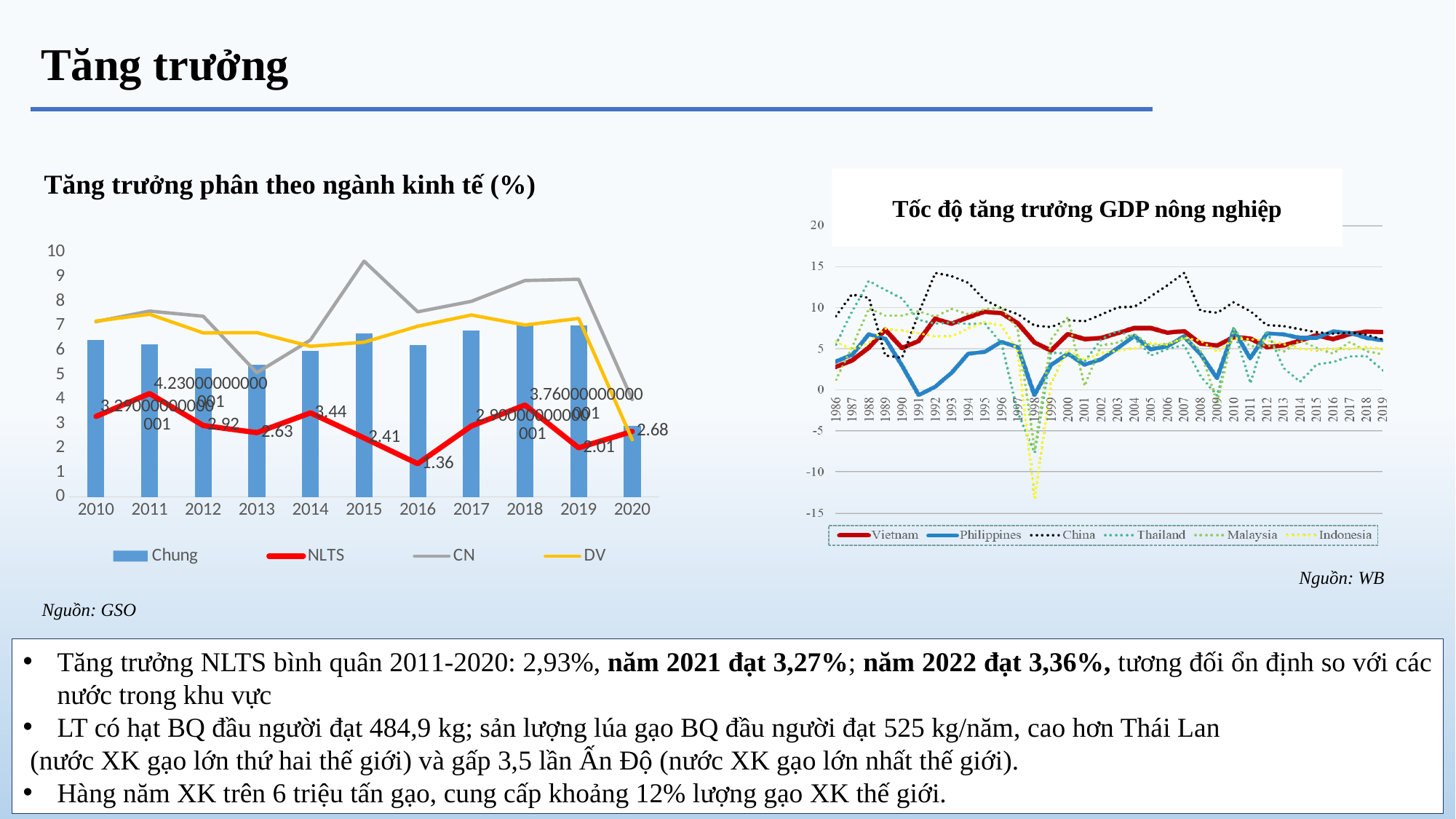
In the chart 'Tăng trưởng phân theo ngành kinh tế (%)', is the Chung value for 2012 greater or less than 6? less In the chart 'Tăng trưởng phân theo ngành kinh tế (%)', which year has the lowest NLTS value? 2016 In the chart 'Tăng trưởng phân theo ngành kinh tế (%)', what is the NLTS value for 2016? 1.36 In the chart 'Tốc độ tăng trưởng GDP nông nghiệp', is the Indonesia value for 1998 greater or less than -10? less In the chart 'Tăng trưởng phân theo ngành kinh tế (%)', what is the NLTS value for 2014? 3.44 How many series does the legend of the chart 'Tốc độ tăng trưởng GDP nông nghiệp' list? 6 In the chart 'Tăng trưởng phân theo ngành kinh tế (%)', what is the NLTS value for 2019? 2.01 In the chart 'Tăng trưởng phân theo ngành kinh tế (%)', is the CN value for 2015 greater or less than 9? greater In the chart 'Tăng trưởng phân theo ngành kinh tế (%)', what is the difference between the NLTS values for 2014 and 2016? 2.08 How many years are shown on the x axis of the chart 'Tăng trưởng phân theo ngành kinh tế (%)'? 11 In the chart 'Tăng trưởng phân theo ngành kinh tế (%)', which year has the highest NLTS value? 2011 In the chart 'Tăng trưởng phân theo ngành kinh tế (%)', which year has the larger NLTS value, 2013 or 2015? 2013